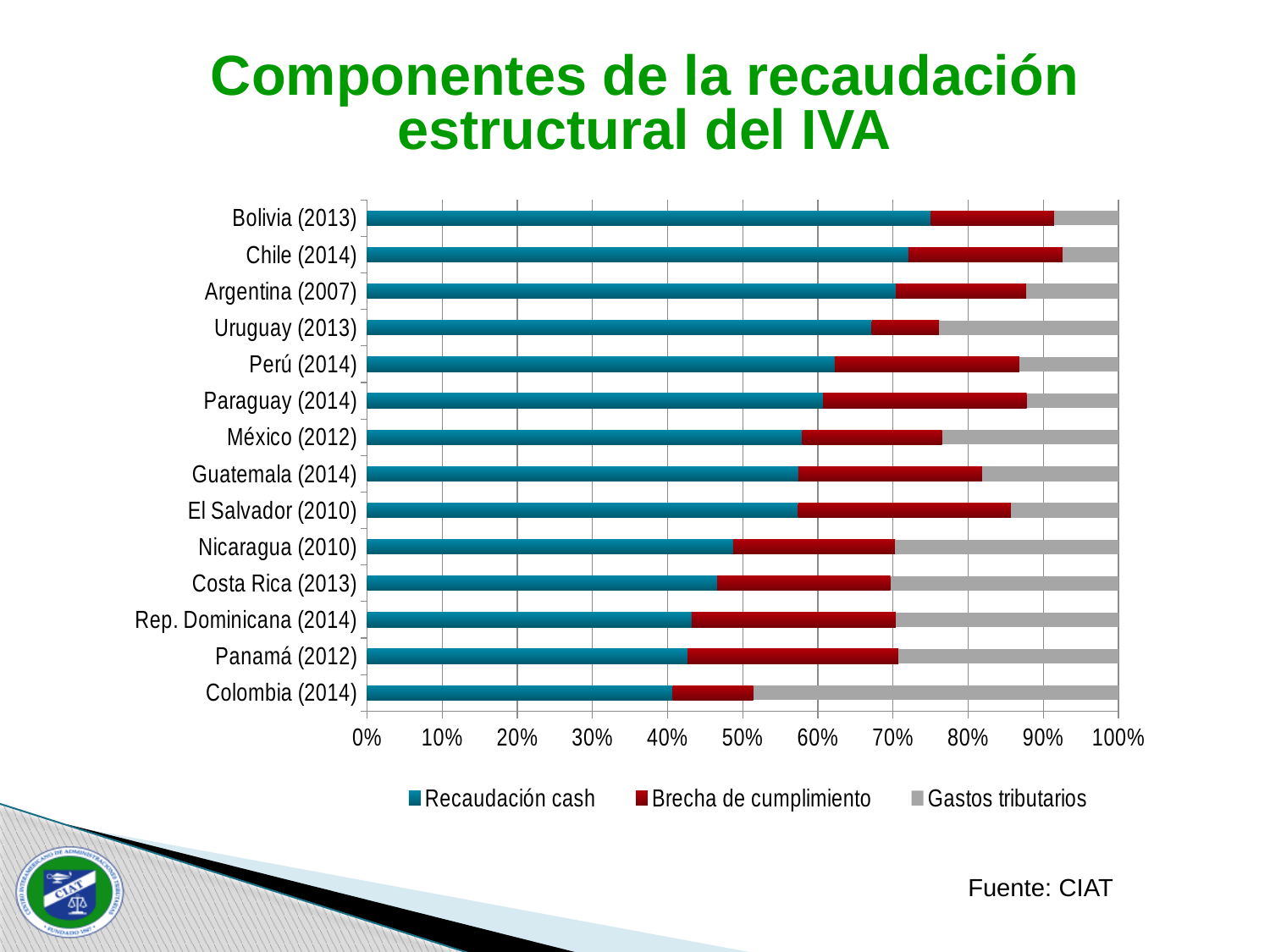
Is the Recaudación cash value for Uruguay (2013) greater or less than 60%? greater What kind of chart is shown on the slide? Stacked bar chart Which country has the largest Recaudación cash share? Bolivia (2013) What is the title of the chart? Componentes de la recaudación estructural del IVA Is the Recaudación cash value for Nicaragua (2010) greater or less than 50%? less Which has a larger Recaudación cash share, Bolivia (2013) or Colombia (2014)? Bolivia (2013) Is the Recaudación cash value for Colombia (2014) greater or less than 50%? less How many series does the legend list? 3 How many countries are listed on the chart? 14 Which country has the largest Gastos tributarios share? Colombia (2014) Going from the top of the chart to the bottom, do the Recaudación cash shares rise or fall? fall